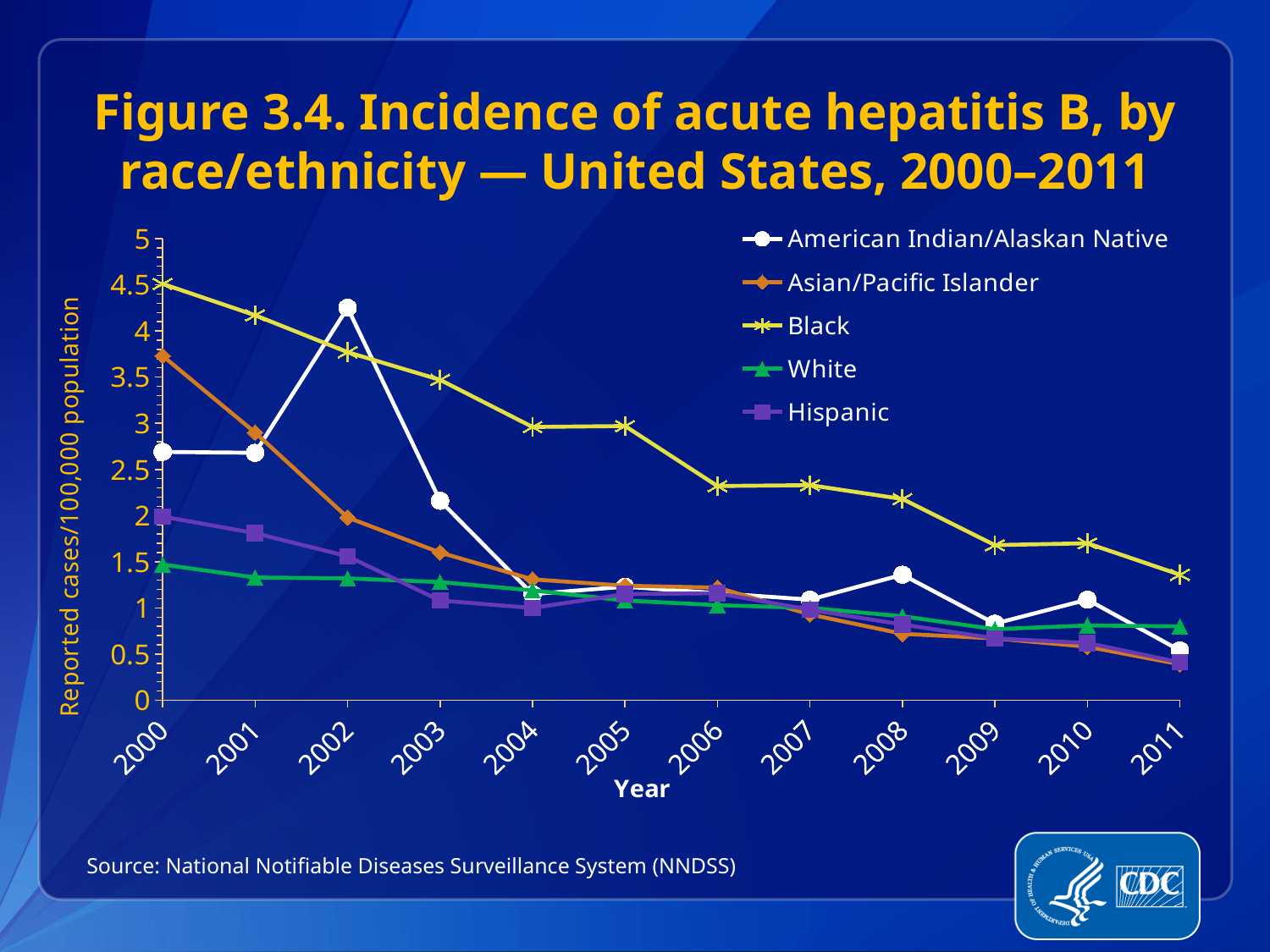
Is the value for American Indian/Alaskan Native in 2002 greater or less than 4? greater In which year does the American Indian/Alaskan Native series reach its highest value? 2002 Is the value for Hispanic in 2000 greater or less than 1.5? greater In 2002, which is higher: American Indian/Alaskan Native or Black? American Indian/Alaskan Native What kind of chart is shown on the slide? line chart How many years are plotted along the x axis? 12 Does the Black series rise or fall from 2000 to 2011? fall What is the label on the y axis? Reported cases/100,000 population Which race/ethnicity group has the lowest incidence in 2000? White How many series does the legend list? 5 Which race/ethnicity group has the highest incidence in 2000? Black Is the value for Black in 2000 greater or less than 4? greater